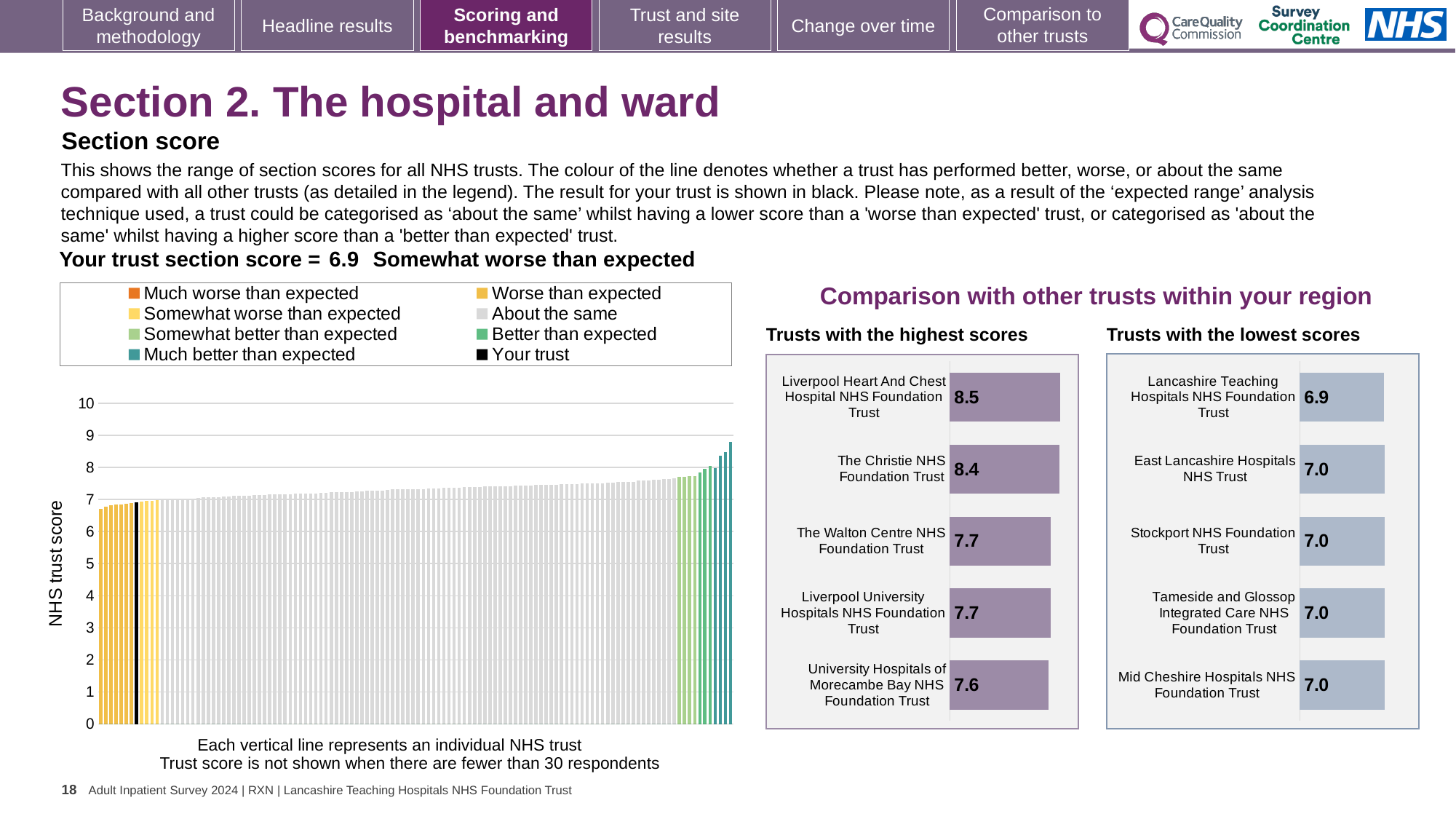
How many entries does the legend of the main NHS trust score chart list? 8 In the 'Trusts with the highest scores' chart, which has the larger score: The Christie NHS Foundation Trust or The Walton Centre NHS Foundation Trust? The Christie NHS Foundation Trust In the 'Trusts with the highest scores' chart, what is the score for The Christie NHS Foundation Trust? 8.4 What kind of chart is the main NHS trust score chart on the left? bar chart In the 'Trusts with the highest scores' chart, which trust has the highest score? Liverpool Heart And Chest Hospital NHS Foundation Trust In the main NHS trust score chart on the left, do the bar values rise or fall from left to right? rise In the 'Trusts with the highest scores' chart, what is the score for Liverpool Heart And Chest Hospital NHS Foundation Trust? 8.5 In the 'Trusts with the lowest scores' chart, which trust has the lowest score? Lancashire Teaching Hospitals NHS Foundation Trust In the 'Trusts with the highest scores' chart, what is the difference between the scores of Liverpool Heart And Chest Hospital NHS Foundation Trust and University Hospitals of Morecambe Bay NHS Foundation Trust? 0.9 In the 'Trusts with the lowest scores' chart, what is the score for Lancashire Teaching Hospitals NHS Foundation Trust? 6.9 How many trusts are listed in the 'Trusts with the lowest scores' chart? 5 In the main NHS trust score chart on the left, is the value of the tallest bar greater or less than 8? greater